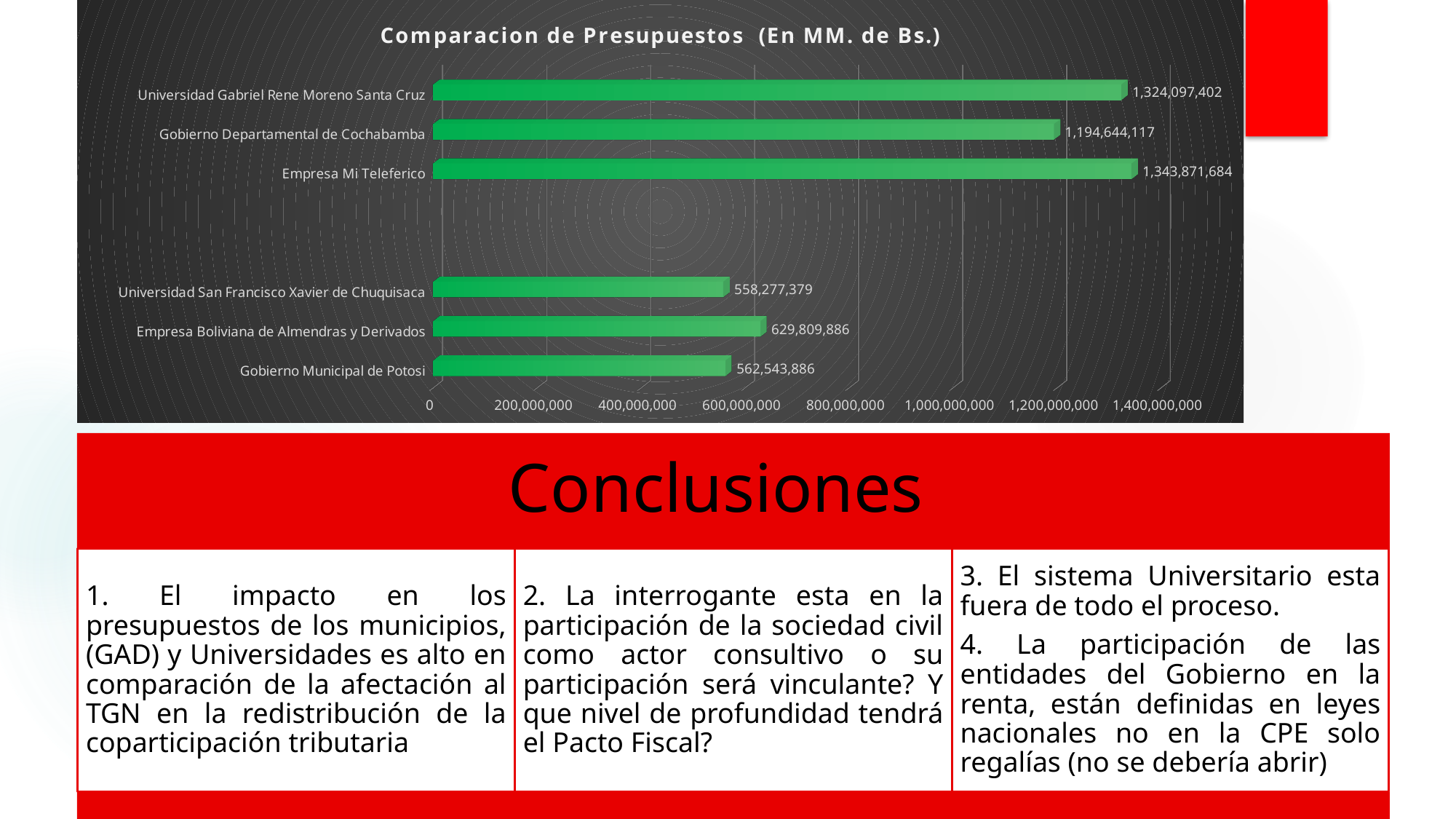
Which is larger, the value for Gobierno Departamental de Cochabamba or the value for Empresa Boliviana de Almendras y Derivados? Gobierno Departamental de Cochabamba What is the value for Gobierno Departamental de Cochabamba? 1,194,644,117 What is the difference between the values for Empresa Boliviana de Almendras y Derivados and Universidad San Francisco Xavier de Chuquisaca? 71,532,507 What is the value for Gobierno Municipal de Potosi? 562,543,886 What kind of chart is shown on the slide? Bar chart What is the value for Empresa Mi Teleferico? 1,343,871,684 Which category has the lowest value? Universidad San Francisco Xavier de Chuquisaca What is the value for Universidad Gabriel Rene Moreno Santa Cruz? 1,324,097,402 What is the difference between the values for Empresa Mi Teleferico and Universidad Gabriel Rene Moreno Santa Cruz? 19,774,282 Which category has the highest value? Empresa Mi Teleferico How many categories are shown in the chart? 6 What is the value for Empresa Boliviana de Almendras y Derivados? 629,809,886